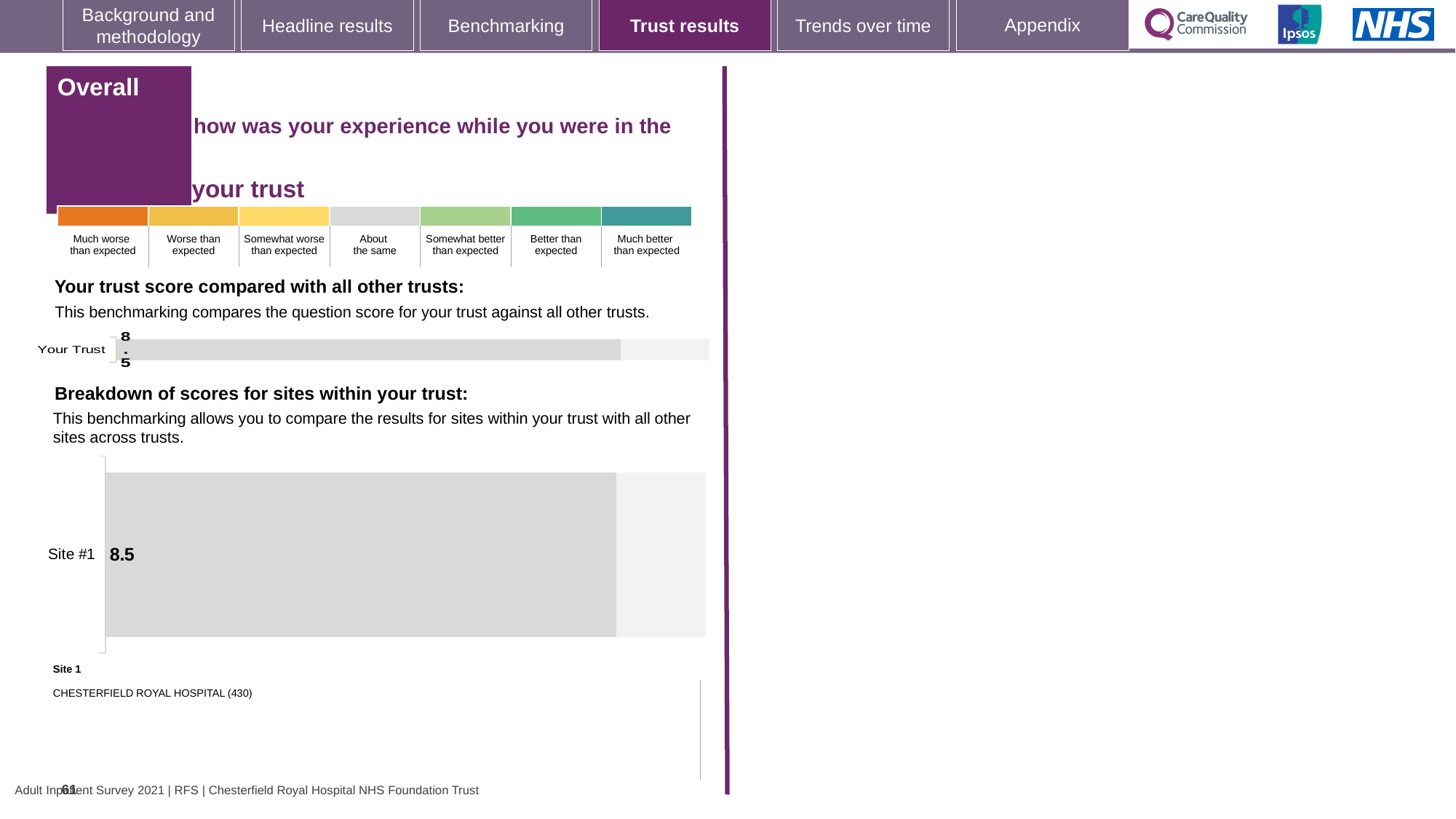
In the 'Your trust score compared with all other trusts' chart, what is the score for Your Trust? 8.5 How many bars are plotted in the 'Your trust score compared with all other trusts' chart? 1 What is the label of the only bar in the 'Breakdown of scores for sites within your trust' chart? Site #1 What is the difference between the Site #1 score and the Your Trust score shown on the slide? 0 What is the label of the only bar in the 'Your trust score compared with all other trusts' chart? Your Trust What kind of chart is the 'Your trust score compared with all other trusts' chart? bar chart How many sites are plotted in the 'Breakdown of scores for sites within your trust' chart? 1 Is the score for Site #1 in the 'Breakdown of scores for sites within your trust' chart the same as the Your Trust score in the 'Your trust score compared with all other trusts' chart? Yes In the 'Breakdown of scores for sites within your trust' chart, what is the score for Site #1? 8.5 What kind of chart is the 'Breakdown of scores for sites within your trust' chart? bar chart